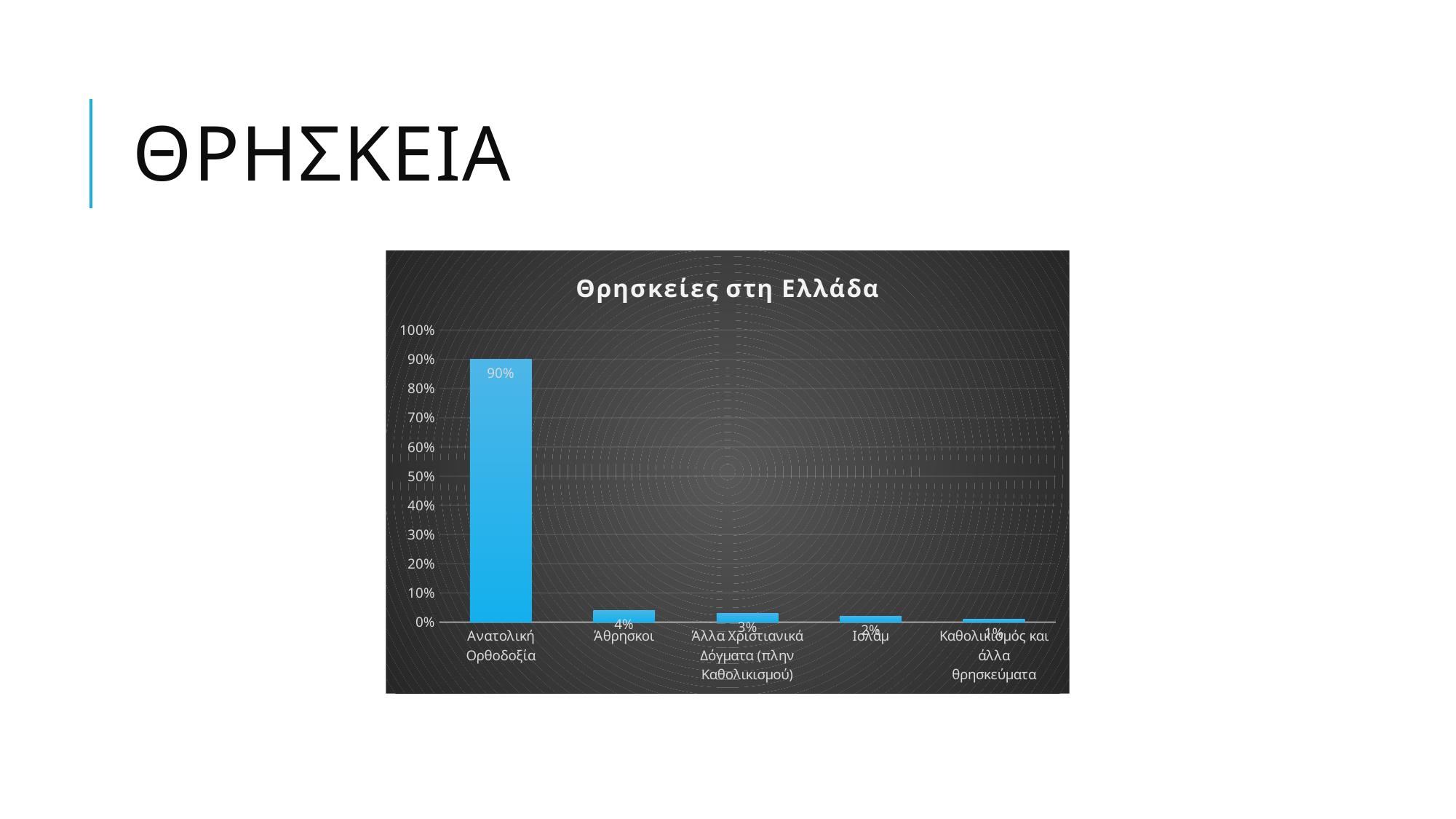
Which category has the highest value? Ανατολική Ορθοδοξία What kind of chart is shown on the slide? bar chart What is the title of the chart? Θρησκείες στη Ελλάδα What is the value for Ισλάμ? 2% Is the value for Ανατολική Ορθοδοξία greater or less than 50%? greater What is the value for Άθρησκοι? 4% Which category has the lowest value? Καθολικισμός και άλλα θρησκεύματα What is the difference between the values for Ανατολική Ορθοδοξία and Άθρησκοι? 86% How many categories are shown in the chart? 5 Which is larger, the value for Άθρησκοι or the value for Ισλάμ? Άθρησκοι What is the value for Ανατολική Ορθοδοξία? 90% What is the value for Άλλα Χριστιανικά Δόγματα (πλην Καθολικισμού)? 3%